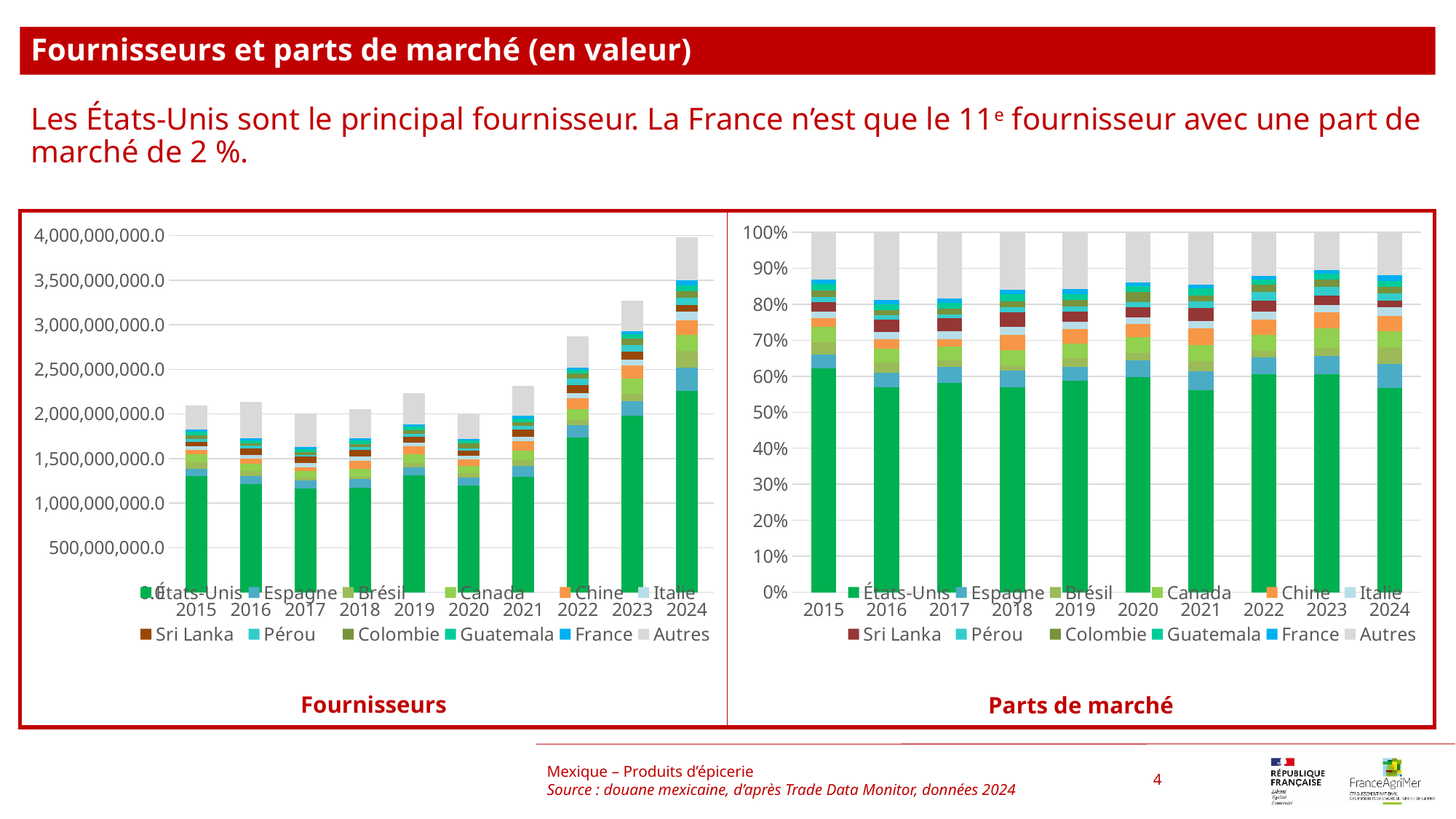
How many series does the legend of the 'Fournisseurs' chart list? 12 In the 'Fournisseurs' chart, is the total for 2024 greater or less than 3,500,000,000.0? greater In the 'Parts de marché' chart, is the share of États-Unis in 2021 greater or less than 60%? less Which series is listed first in the legend of the 'Parts de marché' chart? États-Unis In the 'Fournisseurs' chart, which year has the highest total bar? 2024 How many years are shown on the x axis of the 'Parts de marché' chart? 10 In the 'Parts de marché' chart, is the share of États-Unis in 2015 greater or less than 60%? greater In the 'Fournisseurs' chart, do the total bars rise or fall from 2021 to 2024? rise What kind of chart is the 'Fournisseurs' chart on the left? bar chart In the 'Fournisseurs' chart, is the total bar for 2024 larger than the total bar for 2023? yes